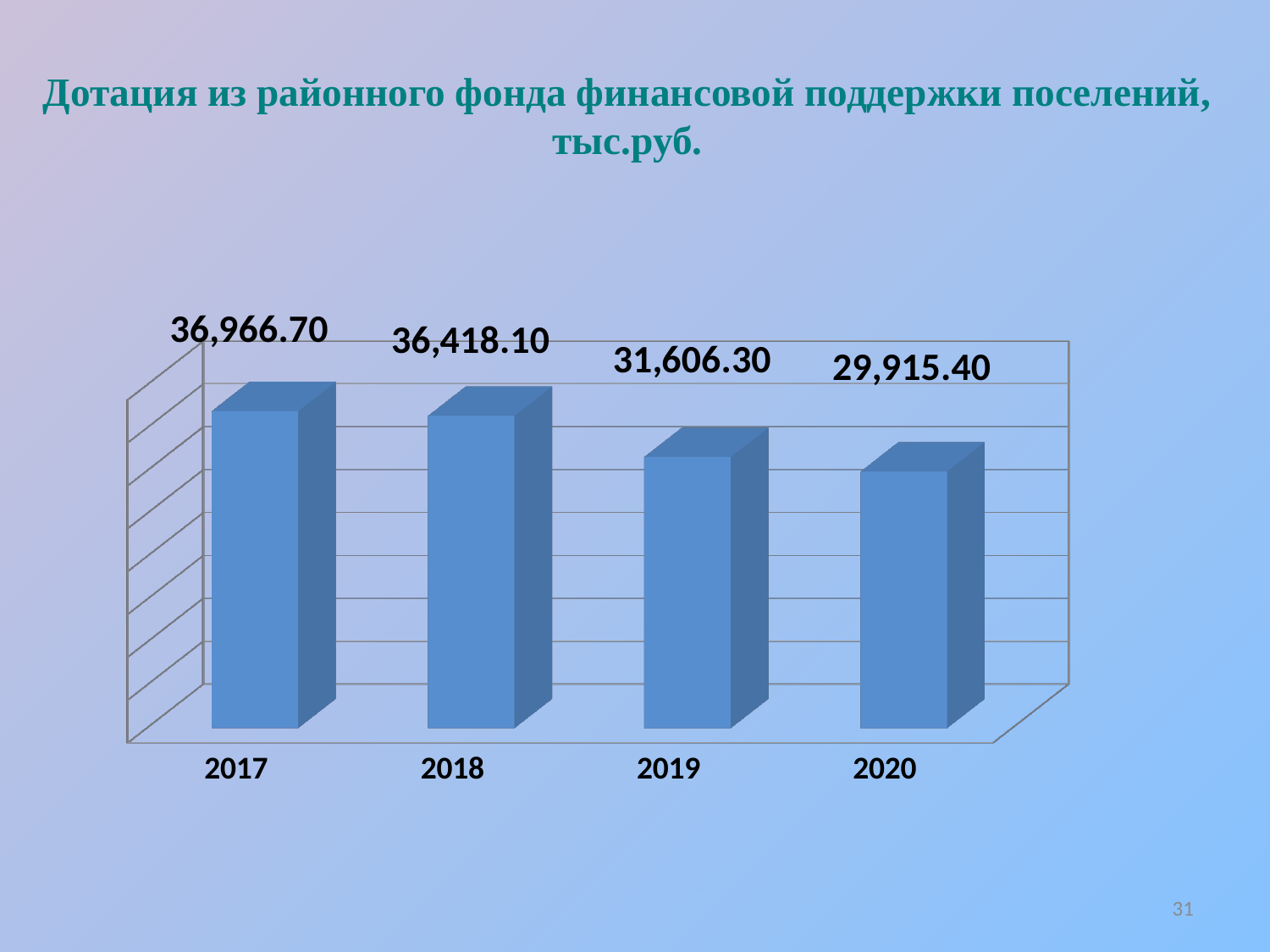
What is the value for 2019? 31,606.30 How many years are shown on the chart? 4 Which year has the highest value? 2017 What is the value for 2020? 29,915.40 Which is larger, the value for 2017 or the value for 2018? 2017 What kind of chart is shown on the slide? Bar chart What is the difference between the values for 2017 and 2020? 7,051.30 What is the value for 2017? 36,966.70 What is the difference between the values for 2018 and 2019? 4,811.80 What is the value for 2018? 36,418.10 Do the values rise or fall from 2017 to 2020? Fall Which year has the lowest value? 2020